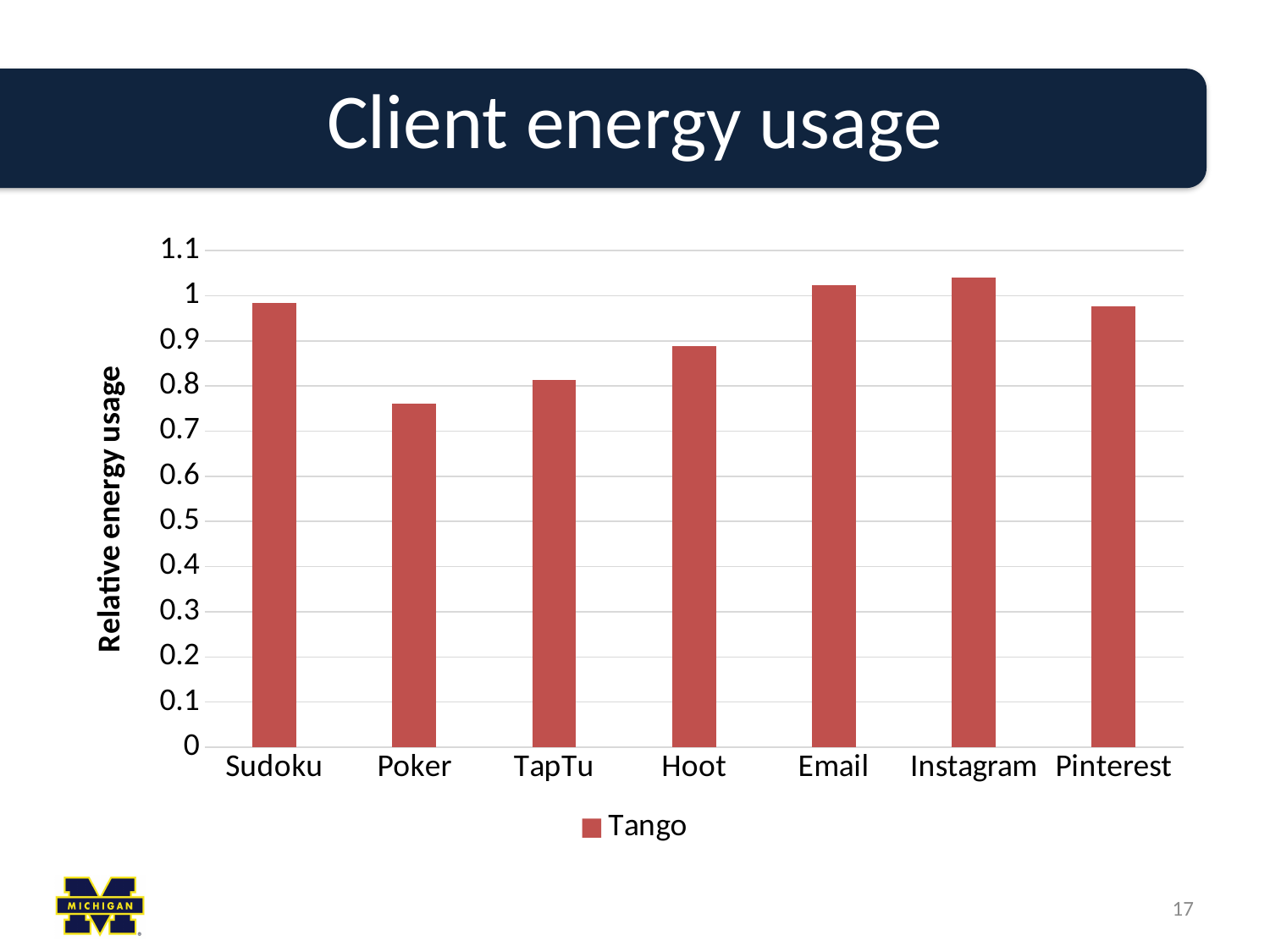
What kind of chart is shown on the slide? bar chart How many series does the legend list? 1 What is the title of the chart's y axis? Relative energy usage Is the value for Hoot greater or less than 0.8? greater Which app has the lowest relative energy usage? Poker Is the value for Email greater or less than 1? greater Is the value for TapTu greater or less than 0.9? less What series name is shown in the chart's legend? Tango Which has the higher relative energy usage, Hoot or TapTu? Hoot How many apps are shown on the x axis of the chart? 7 Which has the higher relative energy usage, Poker or Email? Email